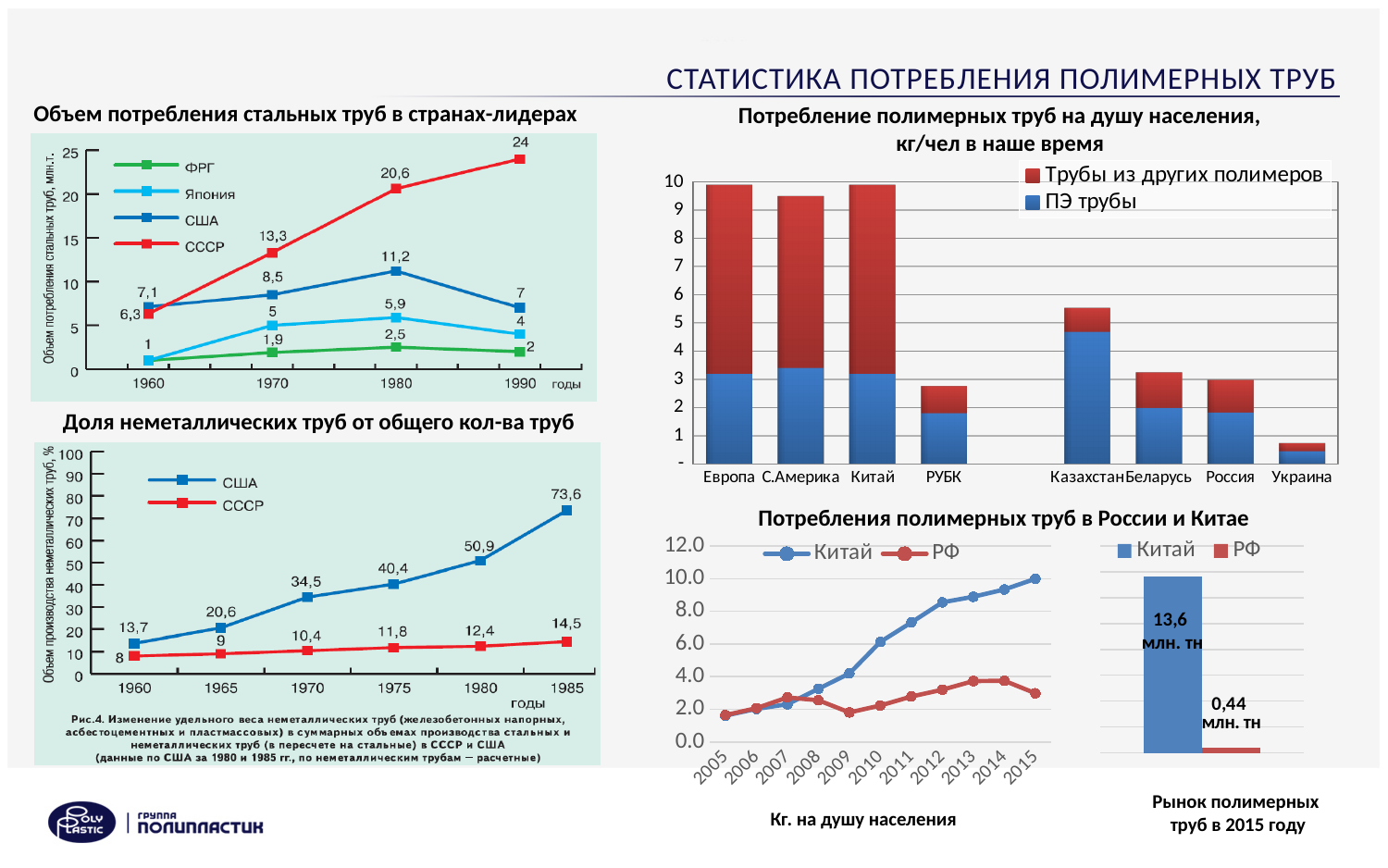
In the chart 'Доля неметаллических труб от общего кол-ва труб', what is the value for СССР in 1960? 8 In the chart 'Доля неметаллических труб от общего кол-ва труб', does the value for США rise or fall from 1960 to 1985? rise In the chart 'Доля неметаллических труб от общего кол-ва труб', what is the difference between США and СССР in 1970? 24,1 In the chart 'Доля неметаллических труб от общего кол-ва труб', what is the value for США in 1985? 73,6 In the chart 'Объем потребления стальных труб в странах-лидерах', which series has the highest value in 1990? СССР In the chart 'Объем потребления стальных труб в странах-лидерах', what is the value for США in 1980? 11,2 In the chart 'Потребление полимерных труб на душу населения, кг/чел в наше время', is the total value for Украина greater or less than 2? less In the chart 'Объем потребления стальных труб в странах-лидерах', how many series does the legend list? 4 In the bar chart 'Рынок полимерных труб в 2015 году' at the bottom right, what is the value for Китай? 13,6 млн. тн In the chart 'Объем потребления стальных труб в странах-лидерах', what is the value for СССР in 1990? 24 In the chart 'Потребление полимерных труб на душу населения, кг/чел в наше время', how many categories are shown on the x axis? 8 What kind of chart is 'Потребление полимерных труб на душу населения, кг/чел в наше время'? bar chart